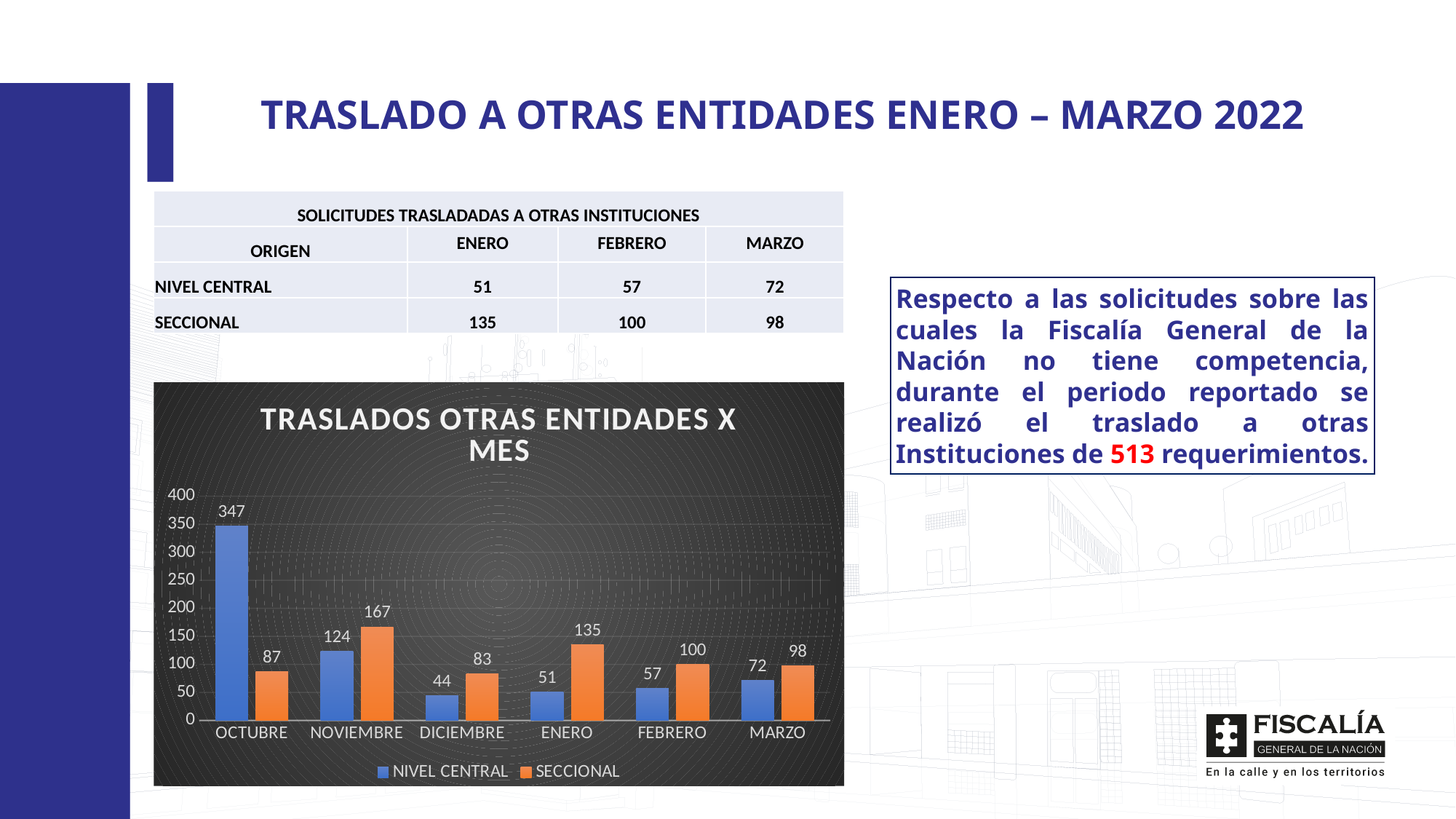
Which month has the lowest NIVEL CENTRAL value? DICIEMBRE Which is larger in MARZO, NIVEL CENTRAL or SECCIONAL? SECCIONAL Which month has the highest NIVEL CENTRAL value? OCTUBRE How many months are shown on the x axis? 6 What is the value for SECCIONAL in NOVIEMBRE? 167 What is the value for SECCIONAL in ENERO? 135 How many series does the legend list? 2 What is the value for NIVEL CENTRAL in OCTUBRE? 347 What is the difference between the SECCIONAL and NIVEL CENTRAL values in FEBRERO? 43 Is the value for NIVEL CENTRAL in NOVIEMBRE greater or less than 100? greater What is the title of the chart? TRASLADOS OTRAS ENTIDADES X MES What kind of chart is shown? Bar chart